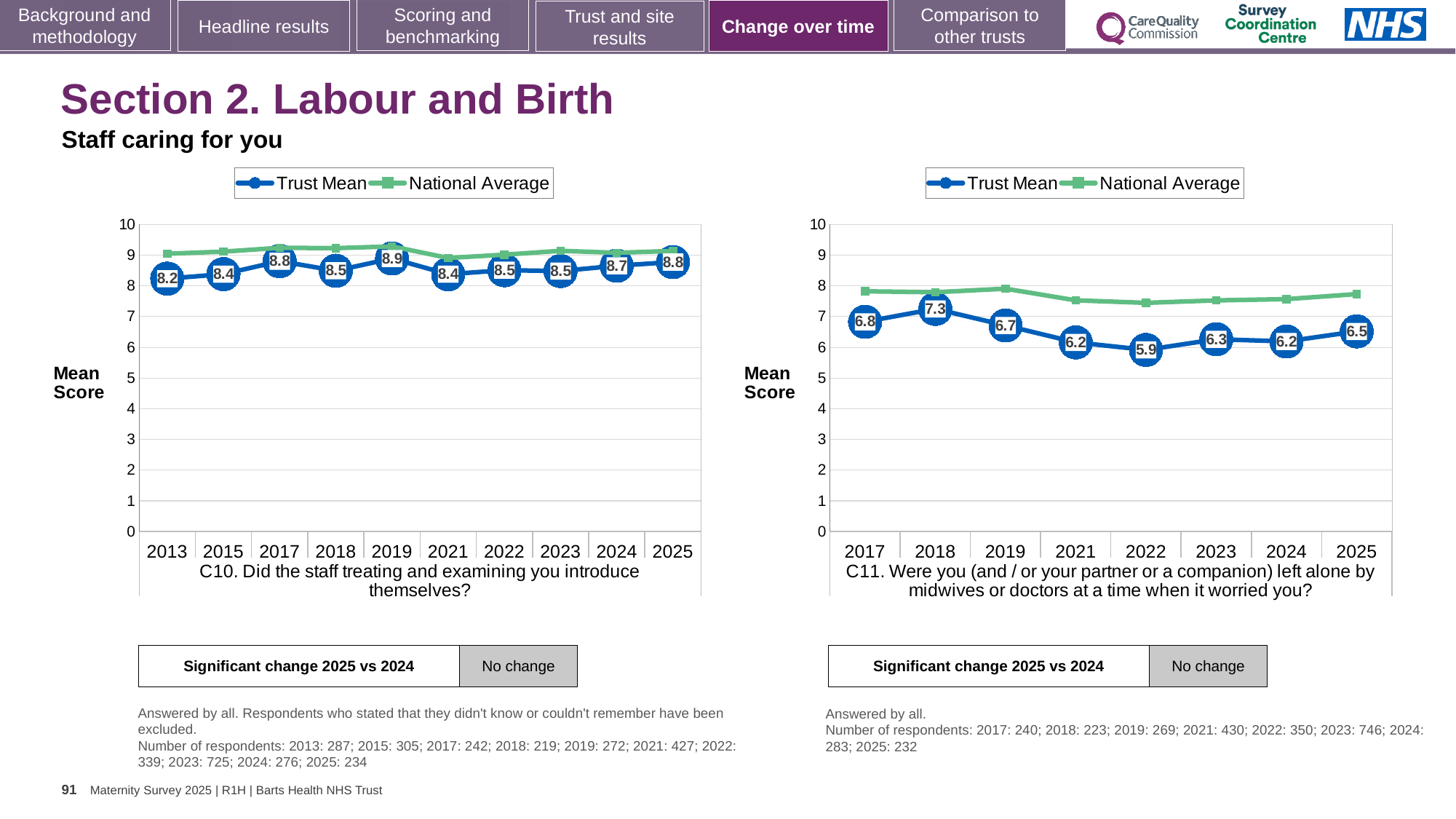
In the right chart (C11), is the National Average for 2017 greater or less than 7? greater In the left chart (C10), is the Trust Mean higher in 2017 or in 2018? 2017 How many years are plotted on the x axis of the right chart (C11)? 8 In the right chart (C11), which year has the lowest Trust Mean? 2022 What type of chart is the left chart (C10)? Line chart In the left chart (C10), what is the Trust Mean for 2013? 8.2 In the right chart (C11), what is the Trust Mean for 2025? 6.5 In the left chart (C10), which year has the lowest Trust Mean? 2013 In the right chart (C11), what is the Trust Mean for 2022? 5.9 In the right chart (C11), what is the difference between the Trust Mean for 2018 and the Trust Mean for 2022? 1.4 In the right chart (C11), which year has the highest Trust Mean? 2018 In the left chart (C10), what is the Trust Mean for 2019? 8.9